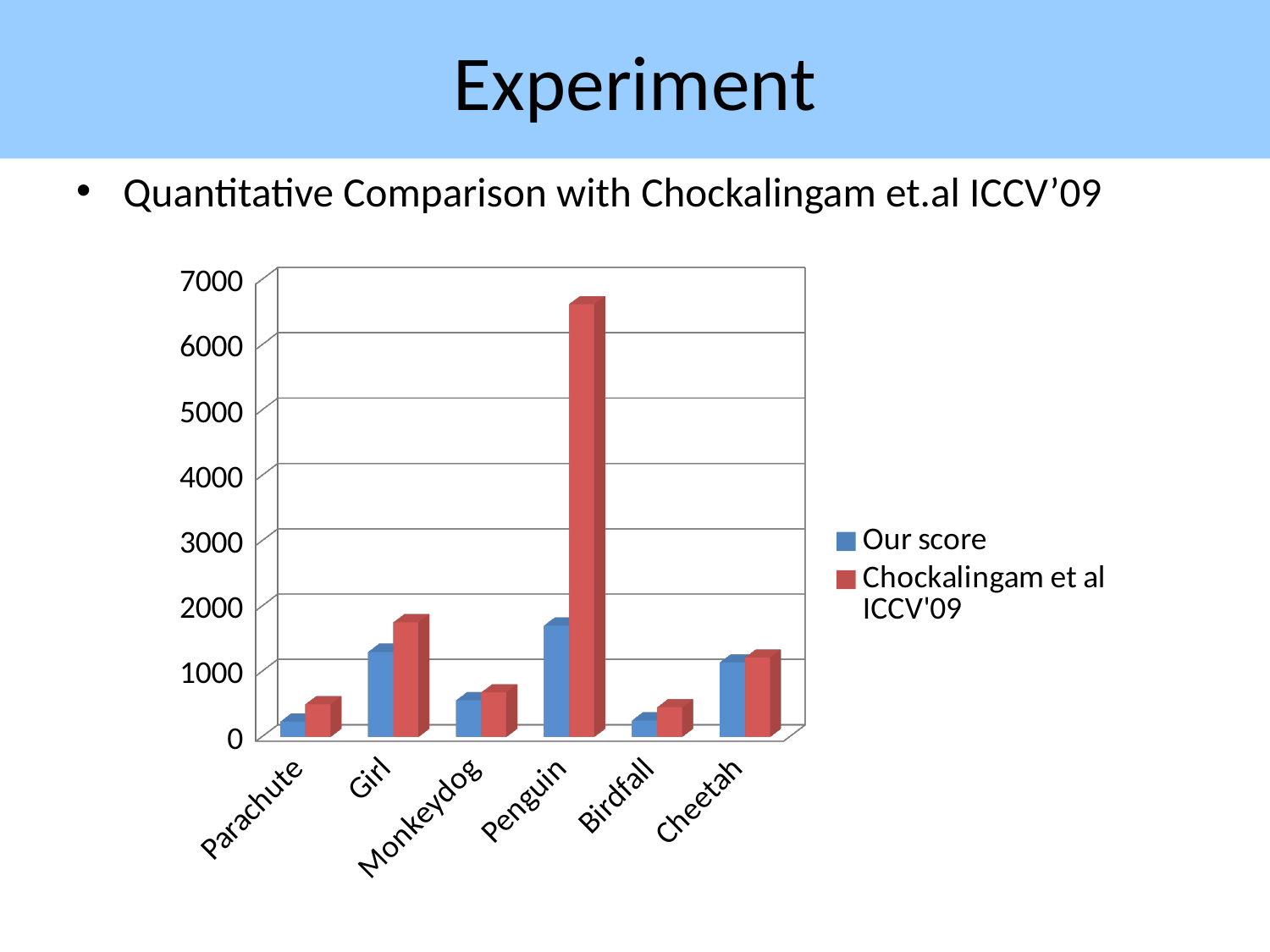
For Penguin, which series has the larger value: Our score or Chockalingam et al ICCV'09? Chockalingam et al ICCV'09 Is the Chockalingam et al ICCV'09 value for Girl greater or less than 2000? less Which category has a larger Our score value: Girl or Monkeydog? Girl Which colour represents the Our score series in the chart? blue How many series does the legend list? 2 What kind of chart is shown on the slide? bar chart How many categories are shown on the x axis? 6 Is the Chockalingam et al ICCV'09 value for Penguin greater or less than 6000? greater Is the Our score value for Parachute greater or less than 1000? less Which category has the highest value for the Chockalingam et al ICCV'09 series? Penguin Which category has the highest value for the Our score series? Penguin